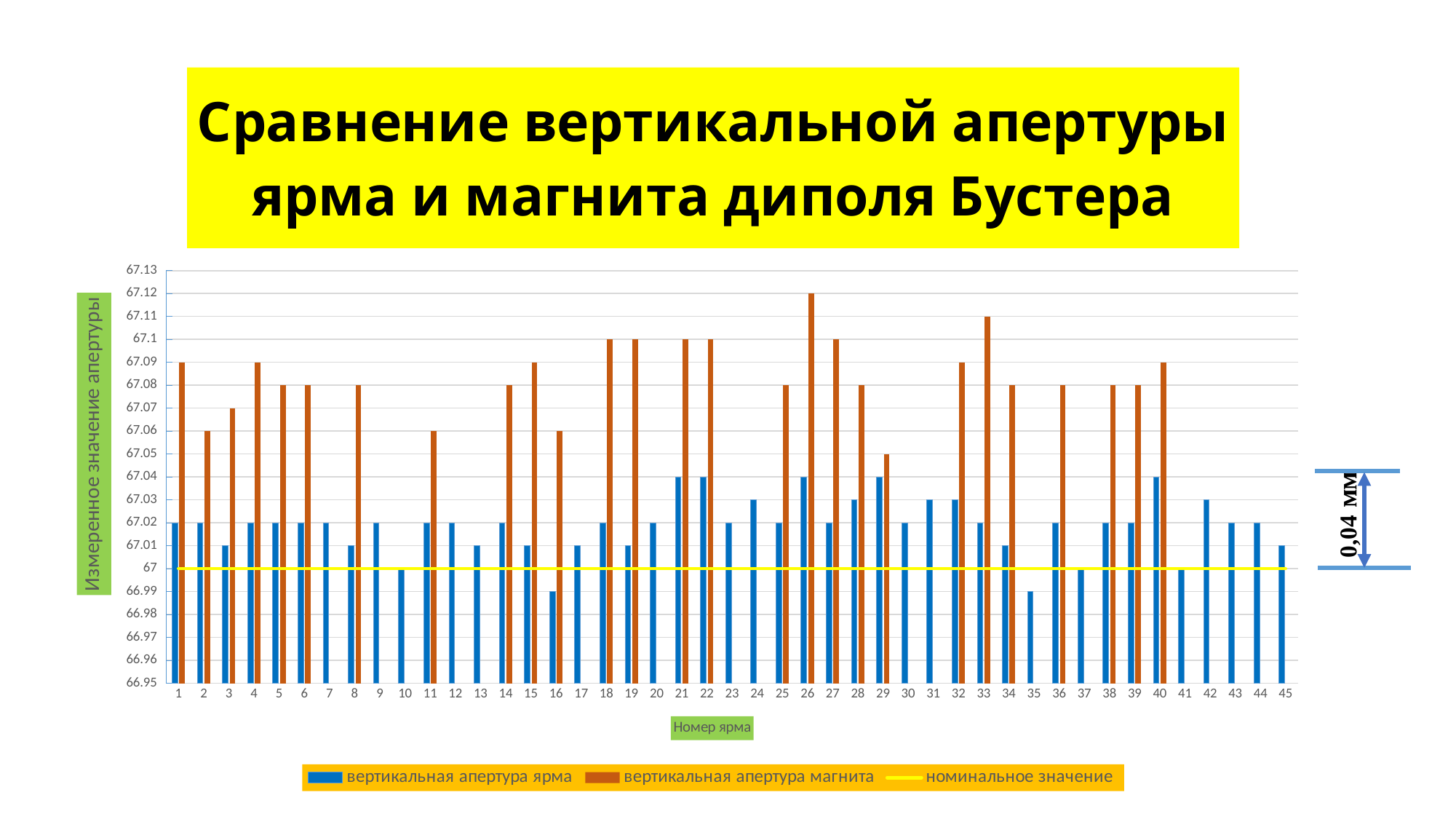
Is the vertical aperture of the yoke for yoke number 16 greater or less than 67? less What is the vertical aperture of the yoke (вертикальная апертура ярма) for yoke number 21? 67.04 At what value is the nominal value line (номинальное значение) drawn? 67 What is the vertical aperture of the magnet for yoke number 26? 67.12 Is the vertical aperture of the magnet for yoke number 33 greater or less than 67.1? greater Which is larger: the vertical aperture of the magnet for yoke number 18 or for yoke number 29? yoke number 18 What kind of chart is shown on the slide? combination bar and line chart What is the label of the x axis? Номер ярма How many series does the legend list? 3 How many yoke numbers (категории) are shown on the x axis? 45 For which yoke number is the vertical aperture of the magnet (вертикальная апертура магнита) the highest? 26 What is the difference between the vertical aperture of the magnet and the vertical aperture of the yoke for yoke number 26? 0.08